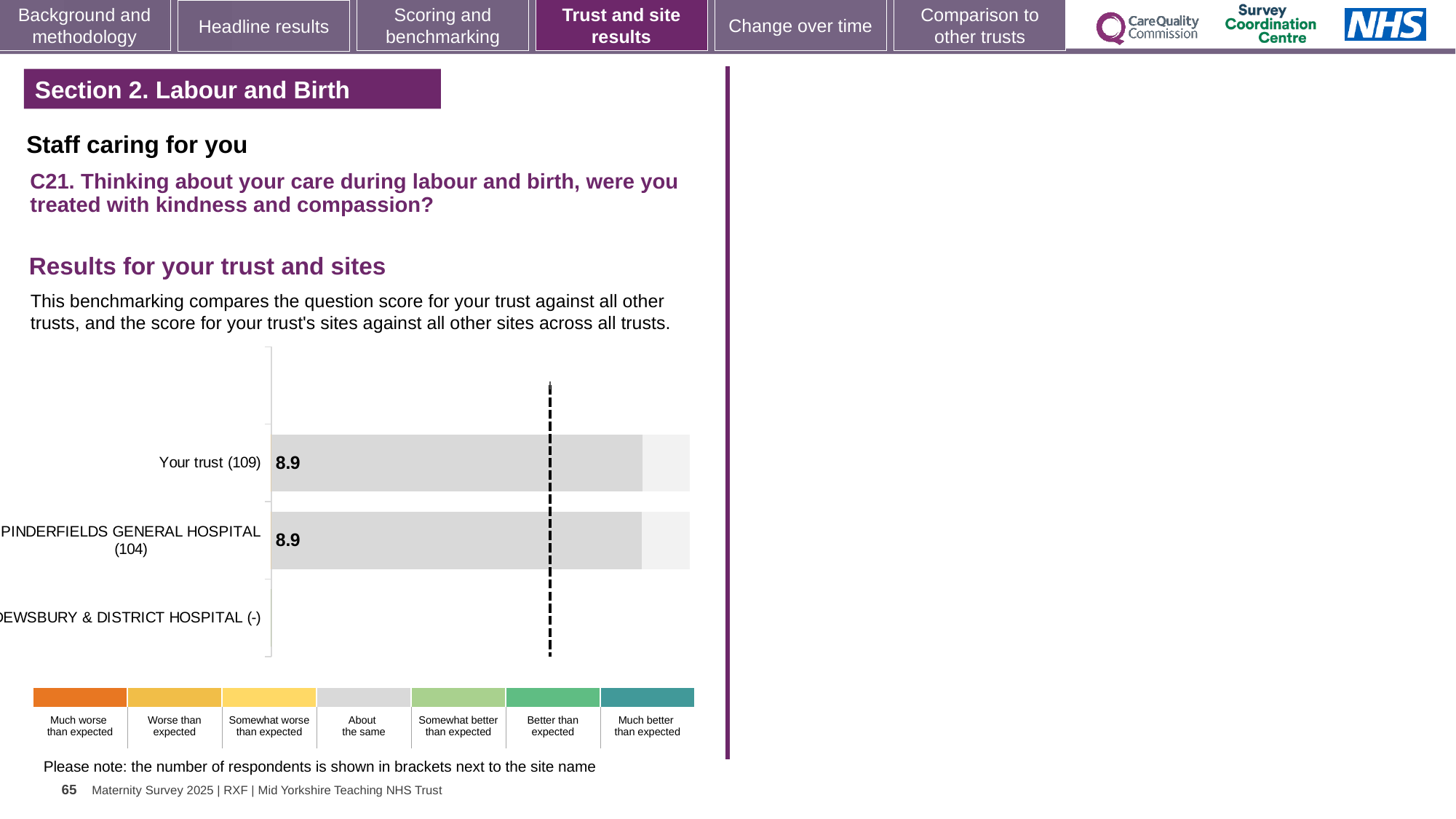
How many benchmark categories does the colour legend below the chart list? 7 How many respondents are shown in brackets for Your trust? 109 What is the score shown for Your trust (109)? 8.9 What is the difference between the score for Your trust and the score for PINDERFIELDS GENERAL HOSPITAL? 0.0 What kind of chart is used to show the results for your trust and sites? bar chart How many respondents are shown in brackets for PINDERFIELDS GENERAL HOSPITAL? 104 Which benchmark category in the legend is shown in grey? About the same How many sites or categories are listed on the vertical axis of the chart? 3 What is the score shown for PINDERFIELDS GENERAL HOSPITAL (104)? 8.9 Is the score for Your trust higher than, lower than, or equal to the score for PINDERFIELDS GENERAL HOSPITAL? equal Which category on the chart has no bar plotted? DEWSBURY & DISTRICT HOSPITAL (-)